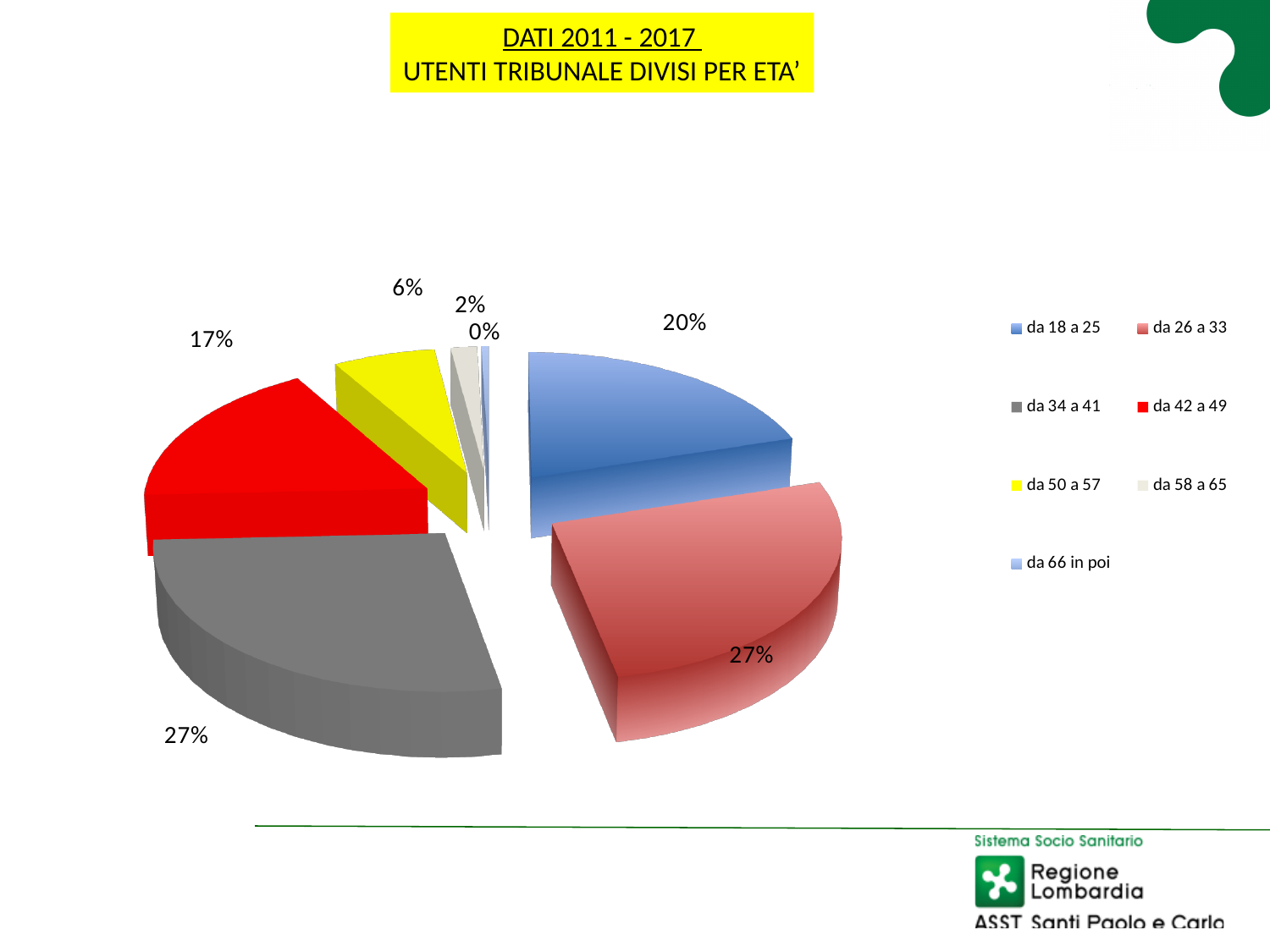
Which age group has the smallest share of the pie? da 66 in poi What kind of chart is shown on the slide? pie chart What percentage of the pie is the 'da 18 a 25' slice? 20% What is the difference in percentage points between the 'da 26 a 33' slice and the 'da 18 a 25' slice? 7 Which slice is larger, 'da 42 a 49' or 'da 50 a 57'? da 42 a 49 What percentage is shown for the 'da 50 a 57' slice? 6% What percentage is shown for the 'da 42 a 49' slice? 17% How many entries does the legend list? 7 How many slices does the pie chart have? 7 What colour is the 'da 50 a 57' slice? yellow What percentage is shown for the 'da 58 a 65' slice? 2% What percentage is shown for the 'da 34 a 41' slice? 27%